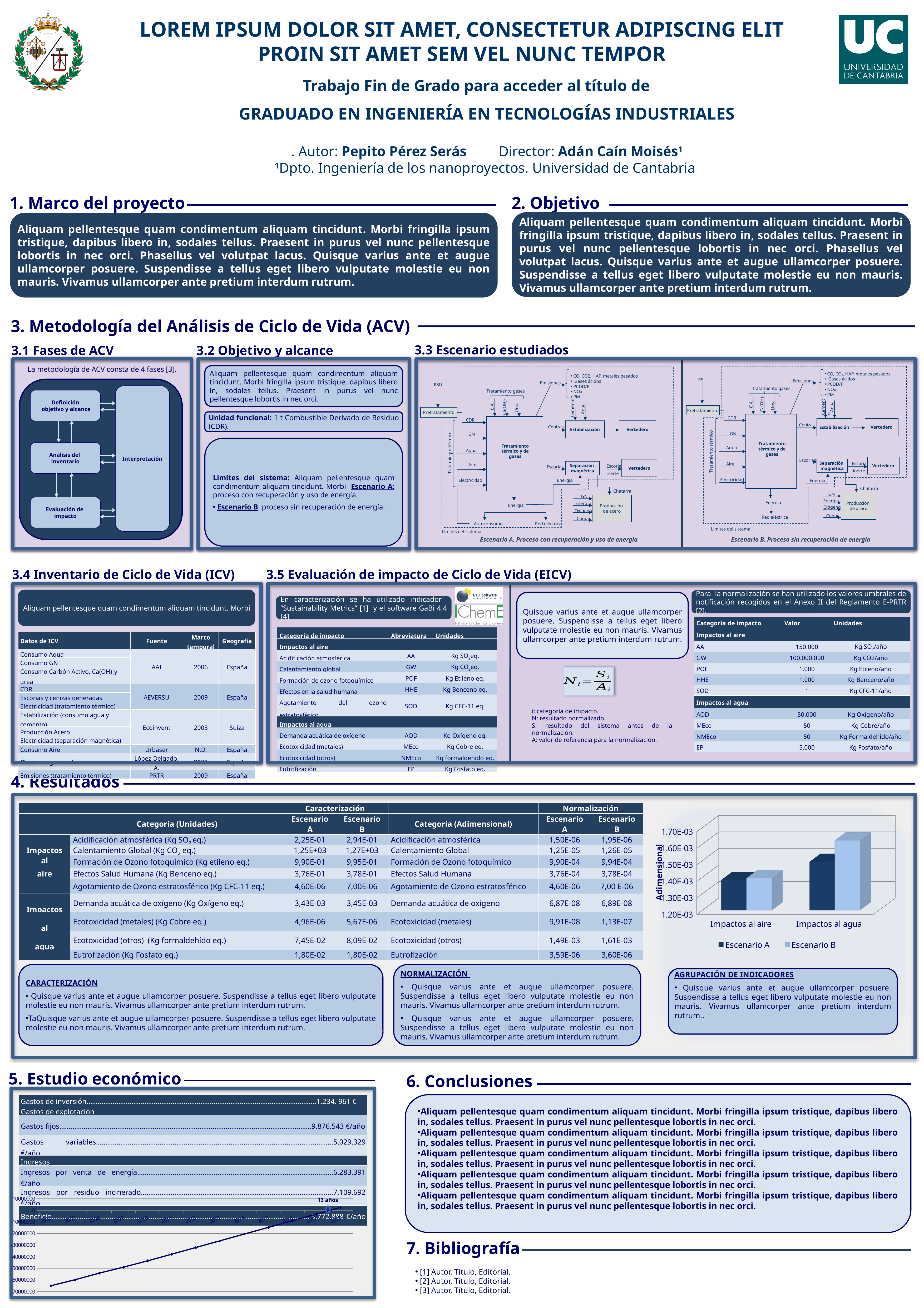
In the bar chart in section 4, which category has the higher Escenario A value? Impactos al agua In the line chart in section 5, do the values rise or fall along the x axis? rise What kind of chart is shown in the Resultados section (section 4)? bar chart In the bar chart in section 4, how many series does the legend list? 2 In the bar chart in section 4, which category has the higher Escenario B value, Impactos al aire or Impactos al agua? Impactos al agua In the bar chart in section 4, how many categories are shown on the x axis? 2 In the bar chart in section 4, what are the two legend entries? Escenario A, Escenario B What kind of chart is shown in the Estudio económico section (section 5)? line chart In the bar chart in section 4, is the Escenario A value for Impactos al aire greater or less than 1.50E-03? less In the bar chart in section 4, is the Escenario B value for Impactos al agua greater or less than 1.50E-03? greater In the bar chart in section 4, what is the label on the vertical axis? Adimensional In the bar chart in section 4, for Impactos al agua, which scenario has the taller bar? Escenario B